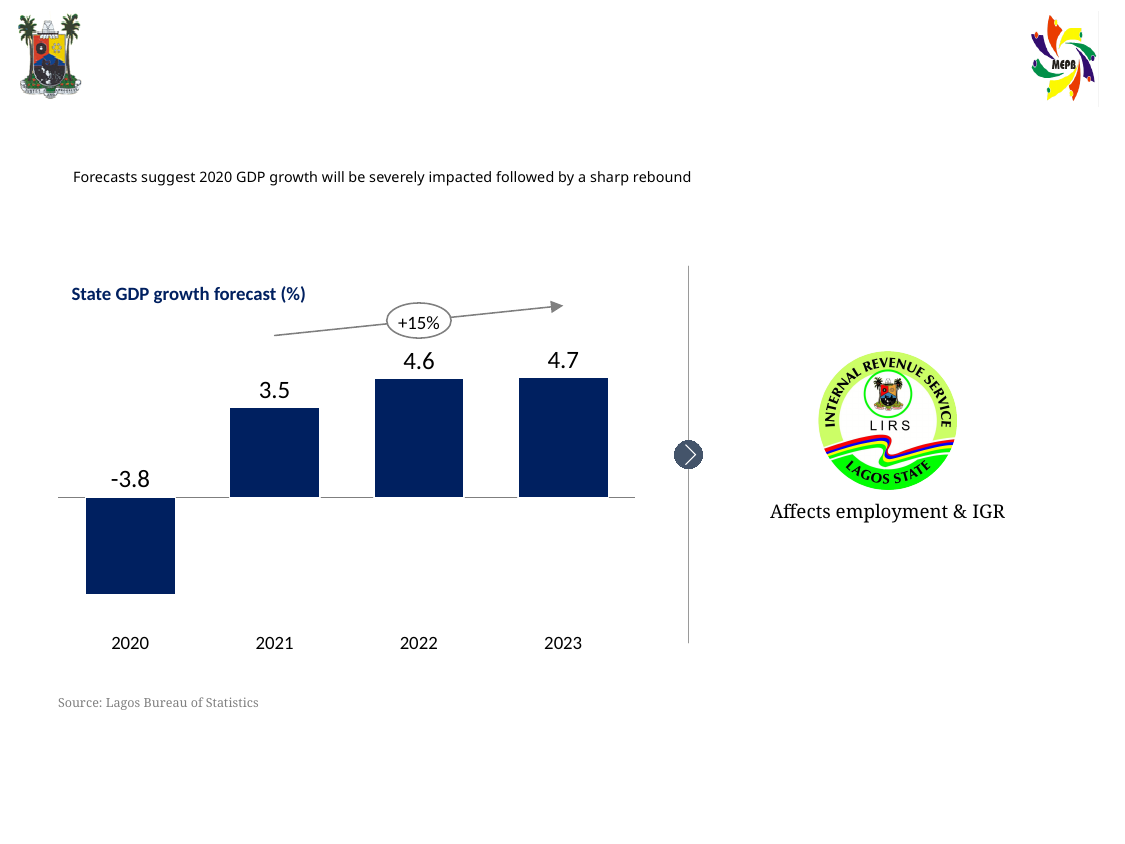
What is the title of the chart on the slide? State GDP growth forecast (%) What is the State GDP growth forecast for 2021? 3.5 Which year has the highest State GDP growth forecast? 2023 What is the State GDP growth forecast for 2023? 4.7 Do the GDP growth forecast values rise or fall from 2020 to 2023? Rise What is the State GDP growth forecast for 2022? 4.6 How many years are shown in the State GDP growth forecast chart? 4 Which year has a larger GDP growth forecast, 2021 or 2022? 2022 Which year has the lowest State GDP growth forecast? 2020 What is the State GDP growth forecast for 2020? -3.8 What is the difference between the GDP growth forecasts for 2022 and 2021? 1.1 What kind of chart is used to show the State GDP growth forecast? Bar chart